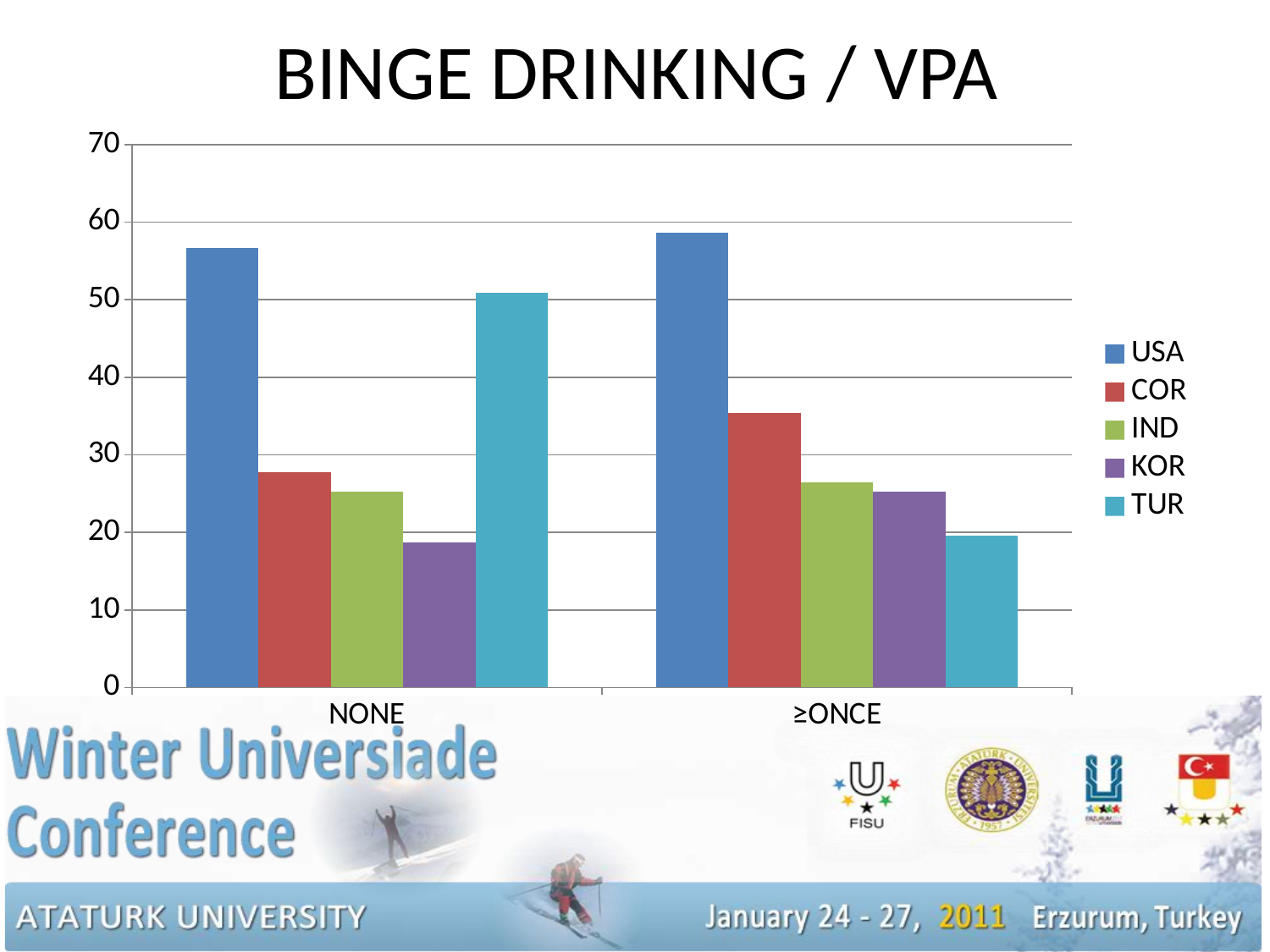
Which is larger, the TUR value for NONE or the TUR value for ≥ONCE? NONE Is the value for TUR in the NONE category greater or less than 50? greater How many categories are shown on the x axis? 2 Which series has the lowest value in the NONE category? KOR Is the value for COR in the ≥ONCE category greater or less than 30? greater What is the title of the chart? BINGE DRINKING / VPA Which series has the lowest value in the ≥ONCE category? TUR What kind of chart is shown on the slide? bar chart Which series has the highest value in the NONE category? USA Which series has the highest value in the ≥ONCE category? USA Is the value for KOR in the NONE category greater or less than 20? less How many series does the legend list? 5